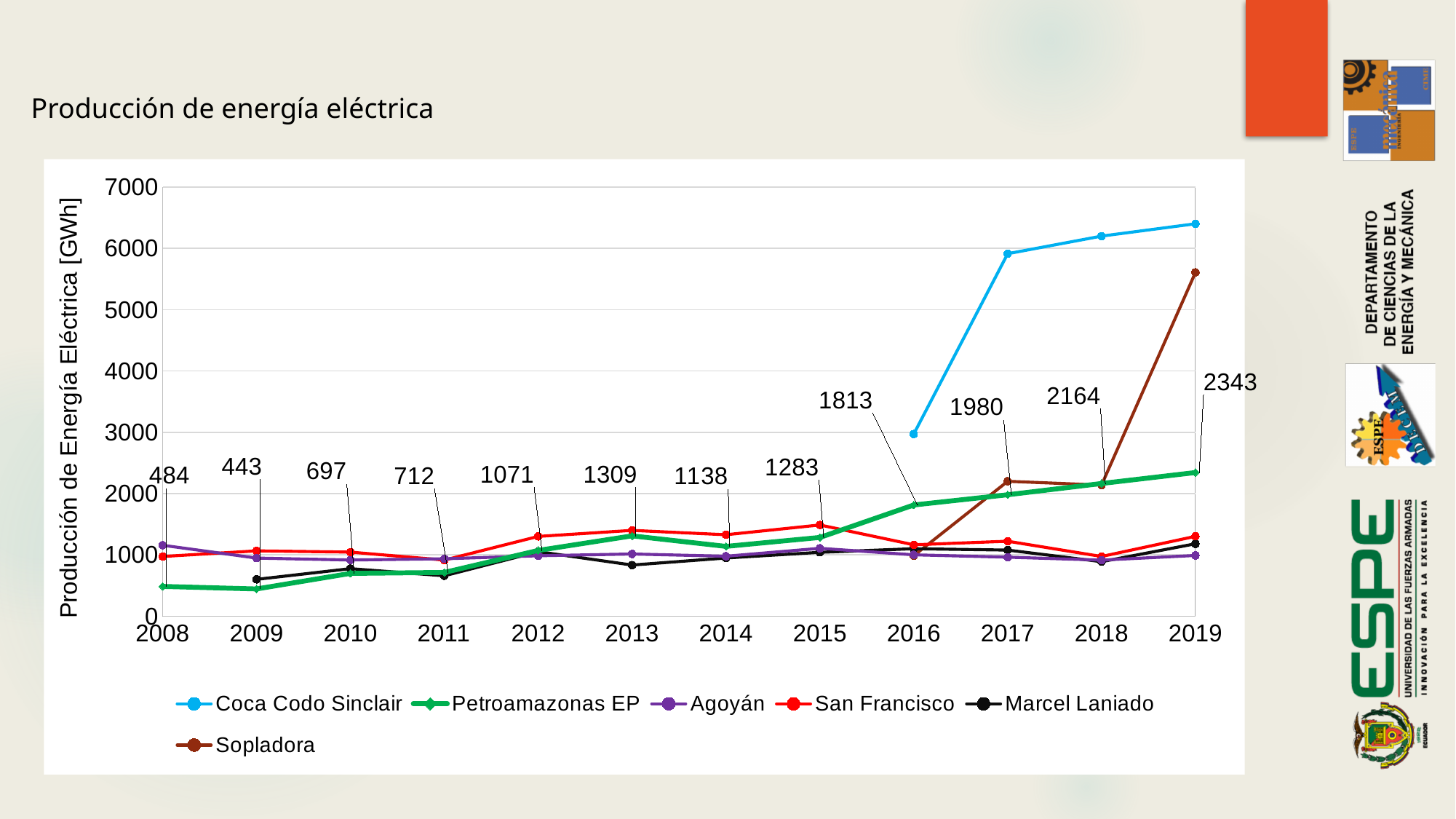
How many years are shown on the x axis? 12 What type of chart is shown on the slide? line chart How many series does the legend list? 6 Is the value for Sopladora in 2019 greater or less than 5000? greater What was the production of Petroamazonas EP in 2009? 443 Which is larger in 2019, Sopladora or Petroamazonas EP? Sopladora What is the difference between Petroamazonas EP's production in 2019 and in 2018? 179 What was the production of Petroamazonas EP in 2013? 1309 What is the label of the y axis? Producción de Energía Eléctrica [GWh] What was the production of Petroamazonas EP in 2019? 2343 Which series has the highest value in 2019? Coca Codo Sinclair Is the value for Coca Codo Sinclair in 2017 greater or less than 5000? greater